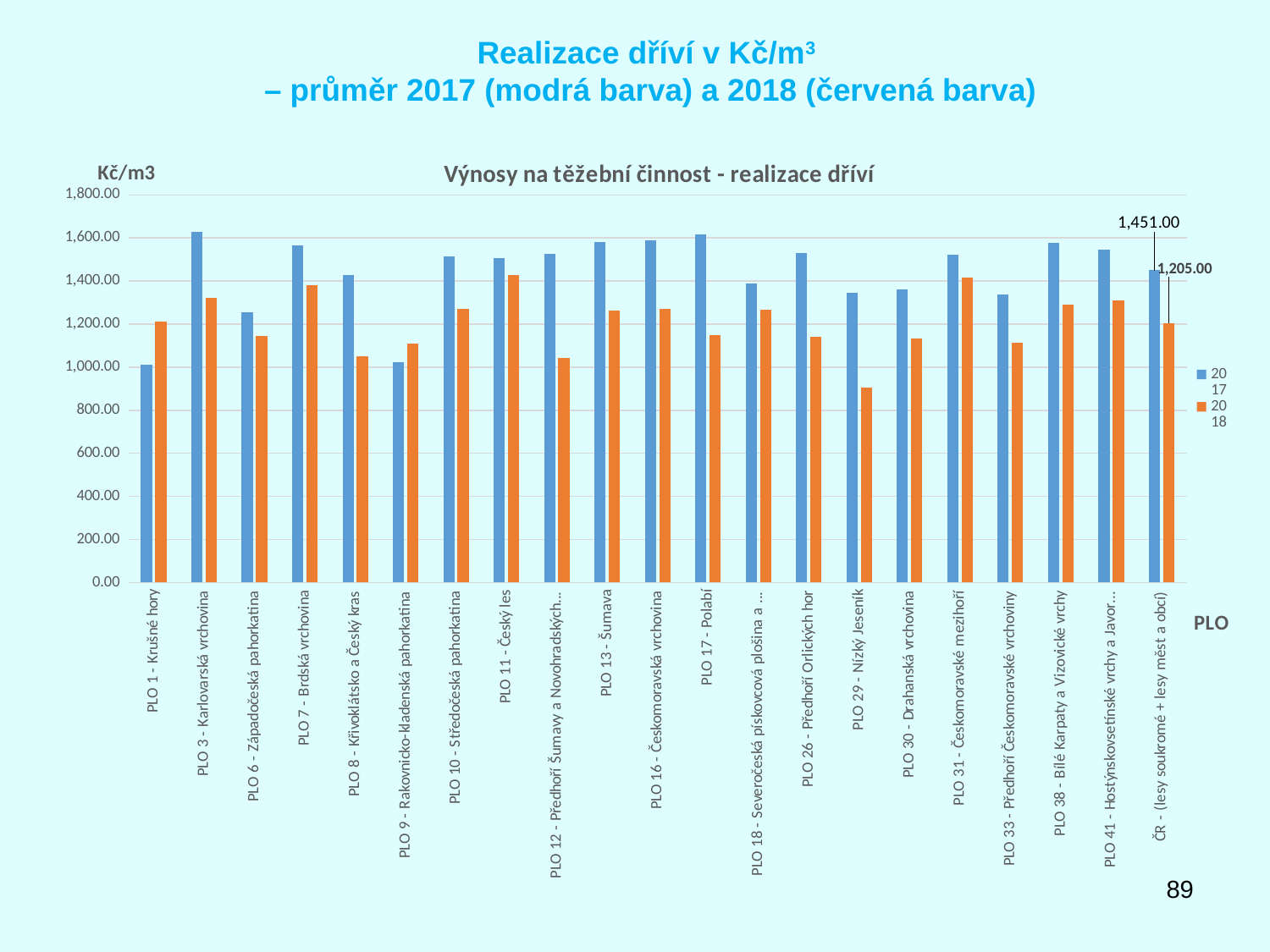
What type of chart is shown on the slide? bar chart How many series does the legend list? 2 Is the 2017 value for PLO 3 - Karlovarská vrchovina greater or less than 1,600.00? greater Which category has the lowest 2018 value? PLO 29 - Nízký Jeseník What is the difference between the 2017 and 2018 values for ČR - (lesy soukromé + lesy měst a obcí)? 246.00 Which series is shown in orange? 2018 What is the 2018 value for ČR - (lesy soukromé + lesy měst a obcí)? 1,205.00 For PLO 17 - Polabí, which is larger: the 2017 value or the 2018 value? 2017 What is the 2017 value for ČR - (lesy soukromé + lesy měst a obcí)? 1,451.00 What is the title of the chart? Výnosy na těžební činnost - realizace dříví Is the 2018 value for PLO 29 - Nízký Jeseník greater or less than 1,000.00? less How many categories (PLO groups) are shown on the x axis? 21